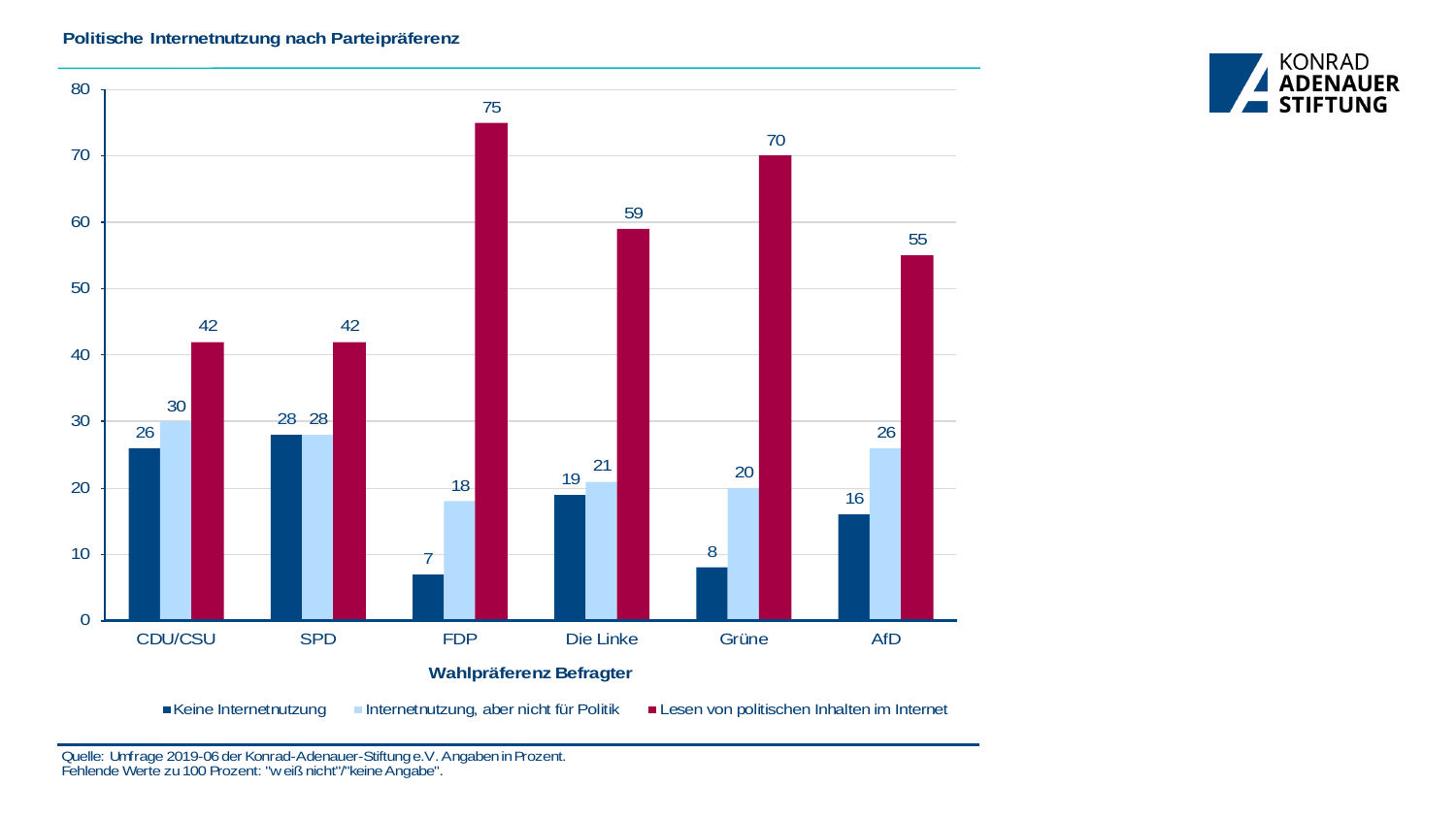
Which party has the highest value for "Lesen von politischen Inhalten im Internet"? FDP Is the value for "Lesen von politischen Inhalten im Internet" for Die Linke greater or less than 50? greater What is the value for "Lesen von politischen Inhalten im Internet" for FDP? 75 Which party has the lowest value for "Keine Internetnutzung"? FDP What is the difference between the "Lesen von politischen Inhalten im Internet" values for Grüne and AfD? 15 How many parties are shown on the x axis? 6 How many series does the legend list? 3 Which is larger: "Keine Internetnutzung" for CDU/CSU or for Die Linke? CDU/CSU What is the value for "Internetnutzung, aber nicht für Politik" for AfD? 26 What kind of chart is shown on the slide? Bar chart What is the value for "Keine Internetnutzung" for Grüne? 8 What is the title of the chart? Politische Internetnutzung nach Parteipräferenz